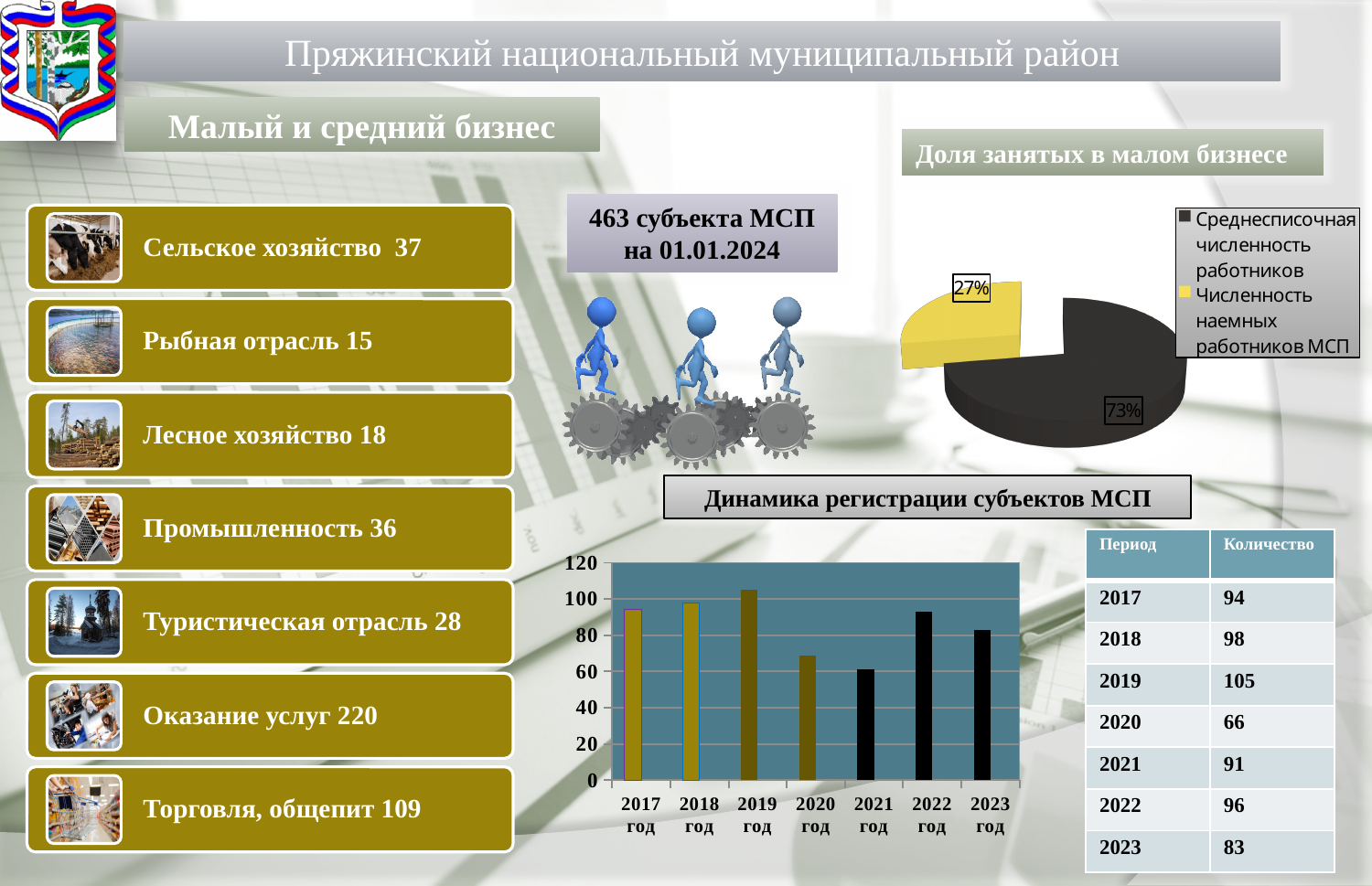
In the chart 'Динамика регистрации субъектов МСП', which year has the lowest value? 2021 год What kind of chart is 'Динамика регистрации субъектов МСП'? Bar chart In the chart 'Динамика регистрации субъектов МСП', is the value for 2020 greater or less than 80? less What kind of chart is 'Доля занятых в малом бизнесе'? Pie chart In the pie chart 'Доля занятых в малом бизнесе', which legend entry corresponds to the larger slice? Среднесписочная численность работников In the chart 'Динамика регистрации субъектов МСП', which year has the highest value? 2019 год In the chart 'Динамика регистрации субъектов МСП', is the value for 2019 greater or less than 100? greater How many entries does the legend of the pie chart 'Доля занятых в малом бизнесе' list? 2 How many years are shown on the x axis of the chart 'Динамика регистрации субъектов МСП'? 7 In the pie chart 'Доля занятых в малом бизнесе', what percentage is shown for the yellow slice? 27% In the pie chart 'Доля занятых в малом бизнесе', what percentage is shown for the dark slice? 73% In the chart 'Динамика регистрации субъектов МСП', which is larger: the value for 2021 or the value for 2023? 2023